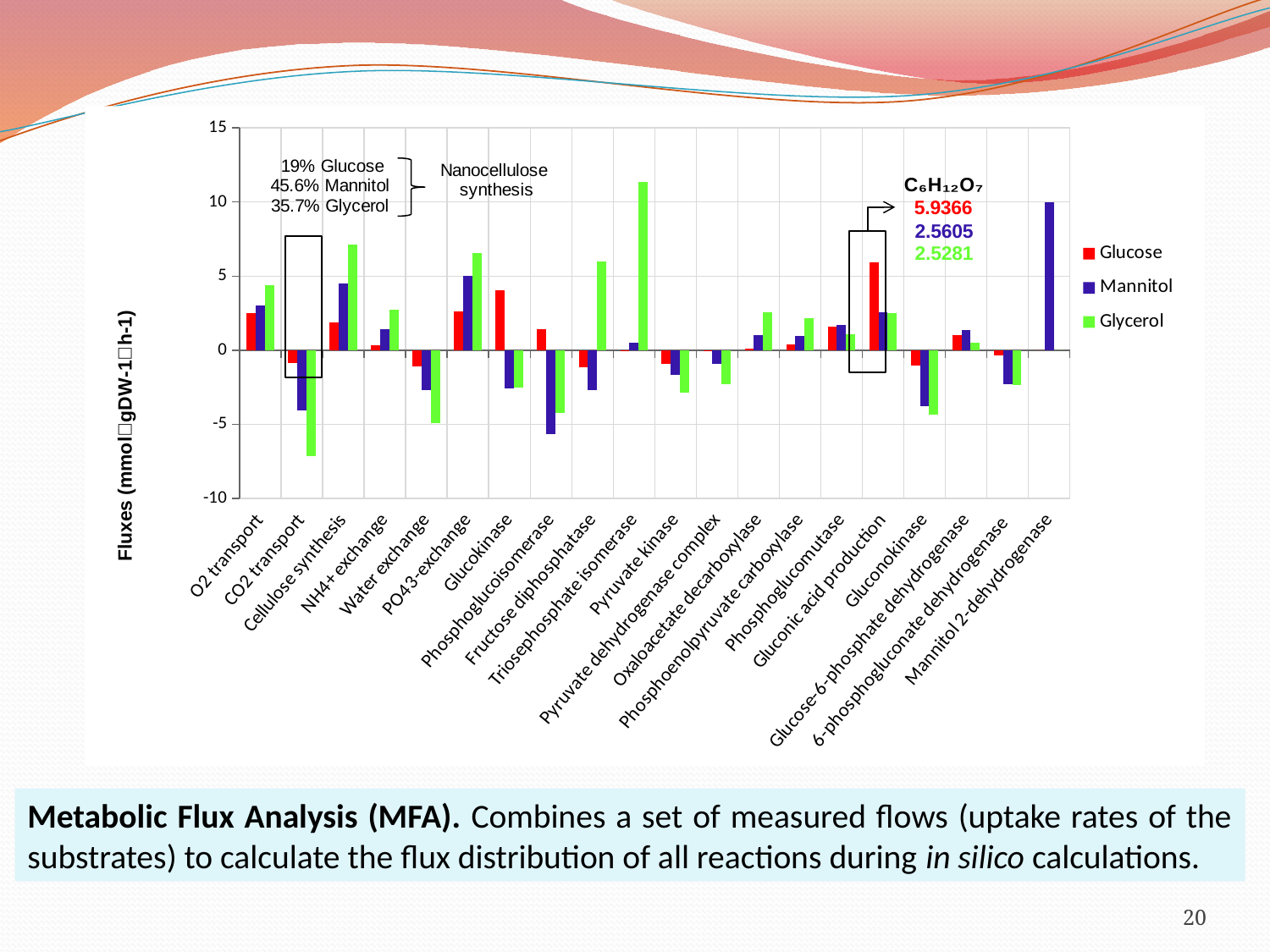
How many reaction categories are shown on the x axis? 20 What is the label of the y axis? Fluxes (mmol·gDW-1·h-1) What is the Glucose value for Gluconic acid production? 5.9366 For Gluconic acid production, what is the difference between the Glucose and Mannitol values? 3.3761 What is the Mannitol value for Gluconic acid production? 2.5605 Which category has the highest Glycerol value? Triosephosphate isomerase Is the Glycerol value for Triosephosphate isomerase greater or less than 10? greater Is the Glycerol value for CO2 transport greater or less than -5? less How many series does the legend list? 3 For Gluconic acid production, which is larger, the Glucose value or the Glycerol value? Glucose What is the Glycerol value for Gluconic acid production? 2.5281 What kind of chart is shown on the slide? bar chart